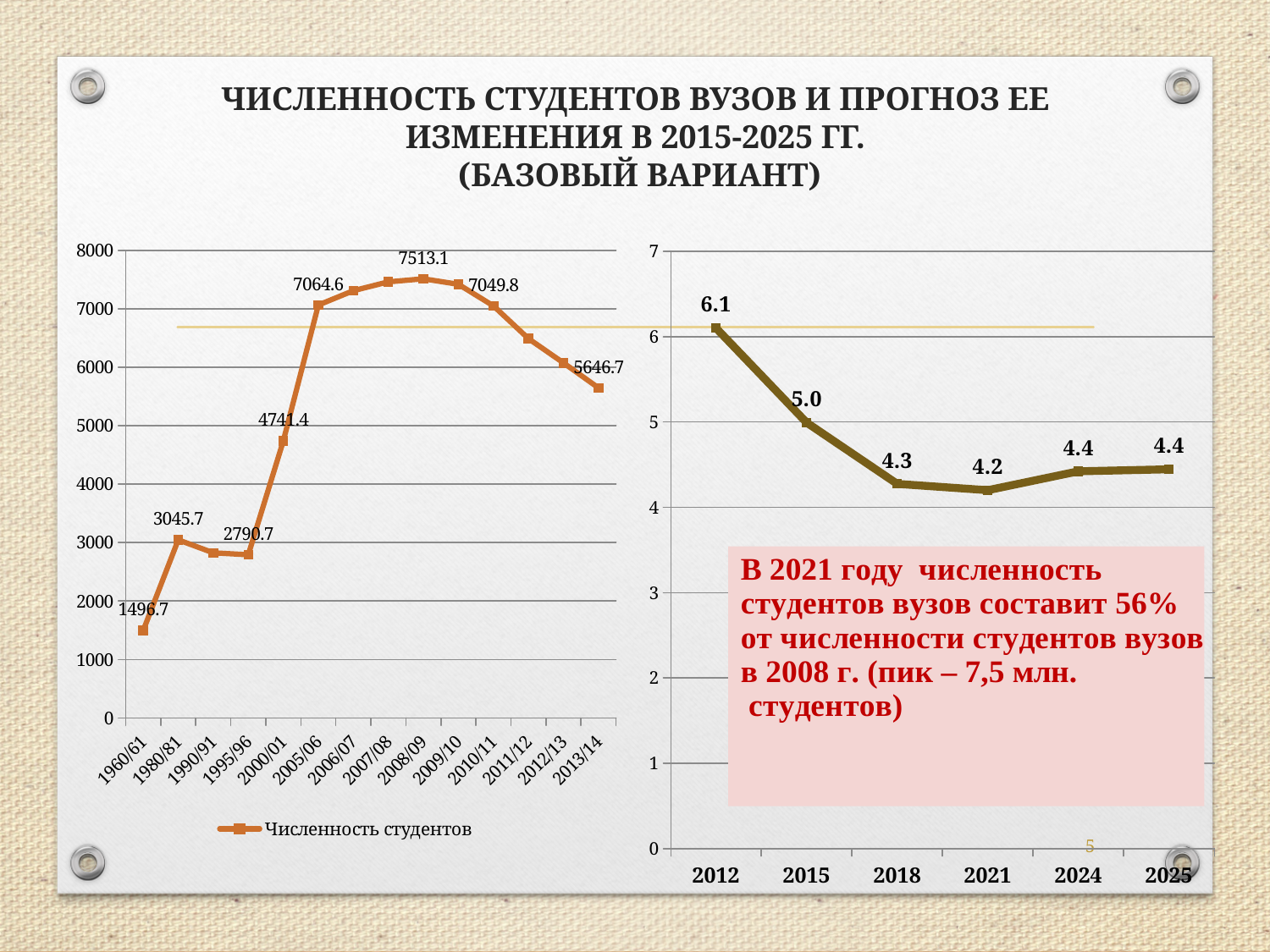
In the left chart, which year has the highest value? 2008/09 What type of chart is the right chart? line chart In the right chart, what is the value for 2021? 4.2 In the right chart, what is the difference between the values for 2012 and 2015? 1.1 In the left chart, what is the difference between the values for 2005/06 and 2000/01? 2323.2 In the left chart, what is the value for 2013/14? 5646.7 In the right chart, which year has the highest value? 2012 In the left chart, which year has the lowest value? 1960/61 In the left chart, what is the value for 1960/61? 1496.7 How many categories are on the x axis of the left chart? 14 In the left chart, what is the value for 2008/09? 7513.1 In the left chart, is the value for 2006/07 greater or less than 7000? greater